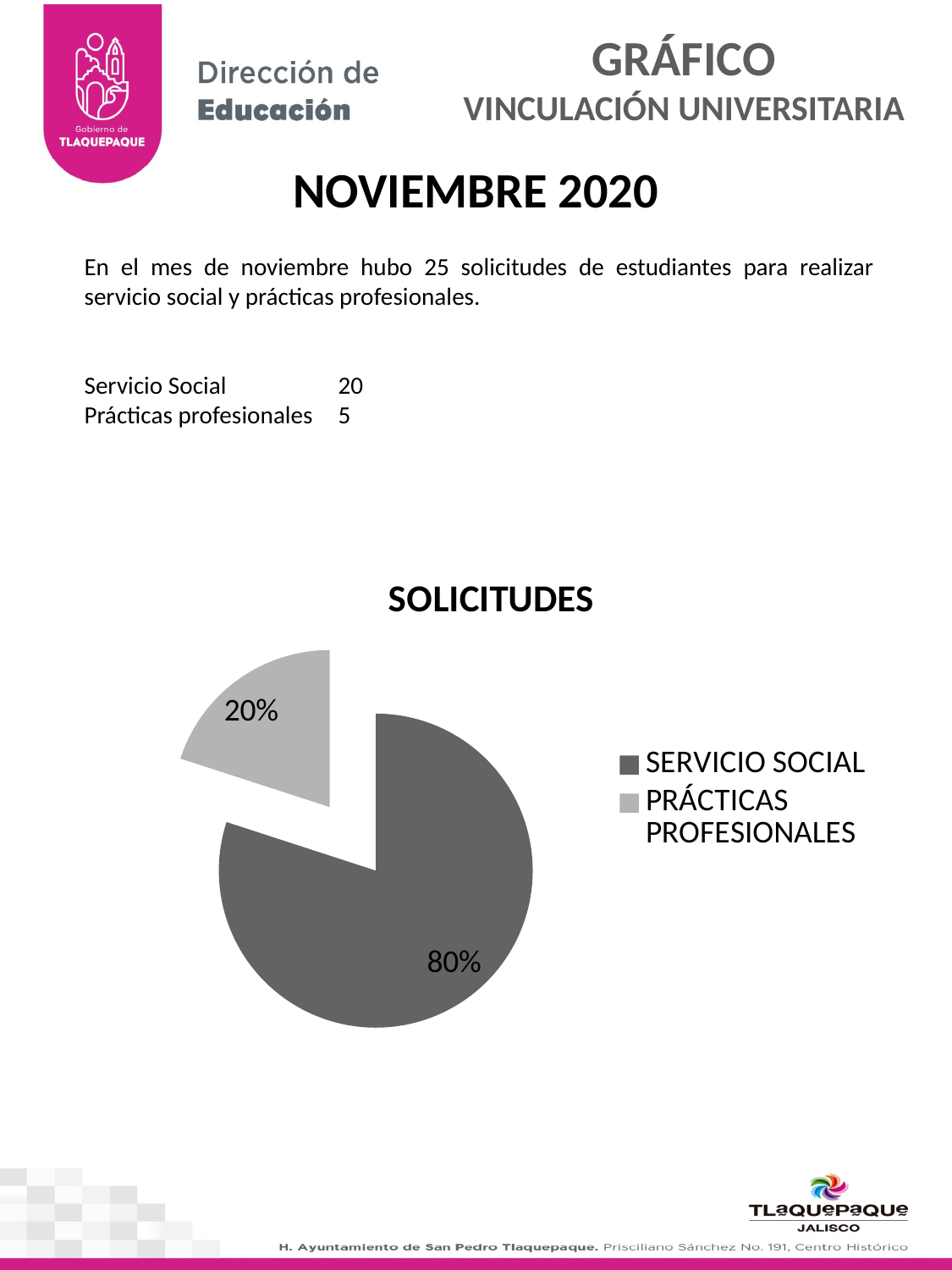
Which slice of the pie is the largest? SERVICIO SOCIAL How many entries does the legend list? 2 What is the title of the chart? SOLICITUDES What kind of chart is shown under the title SOLICITUDES? Pie chart What share of the pie does SERVICIO SOCIAL represent? 80% Which is larger, the share for SERVICIO SOCIAL or the share for PRÁCTICAS PROFESIONALES? SERVICIO SOCIAL What share of the pie does PRÁCTICAS PROFESIONALES represent? 20% How many slices does the pie chart have? 2 Which slice of the pie is the smallest? PRÁCTICAS PROFESIONALES What is the difference in percentage points between the SERVICIO SOCIAL slice and the PRÁCTICAS PROFESIONALES slice? 60% Which legend entry is shown in the lighter grey colour? PRÁCTICAS PROFESIONALES